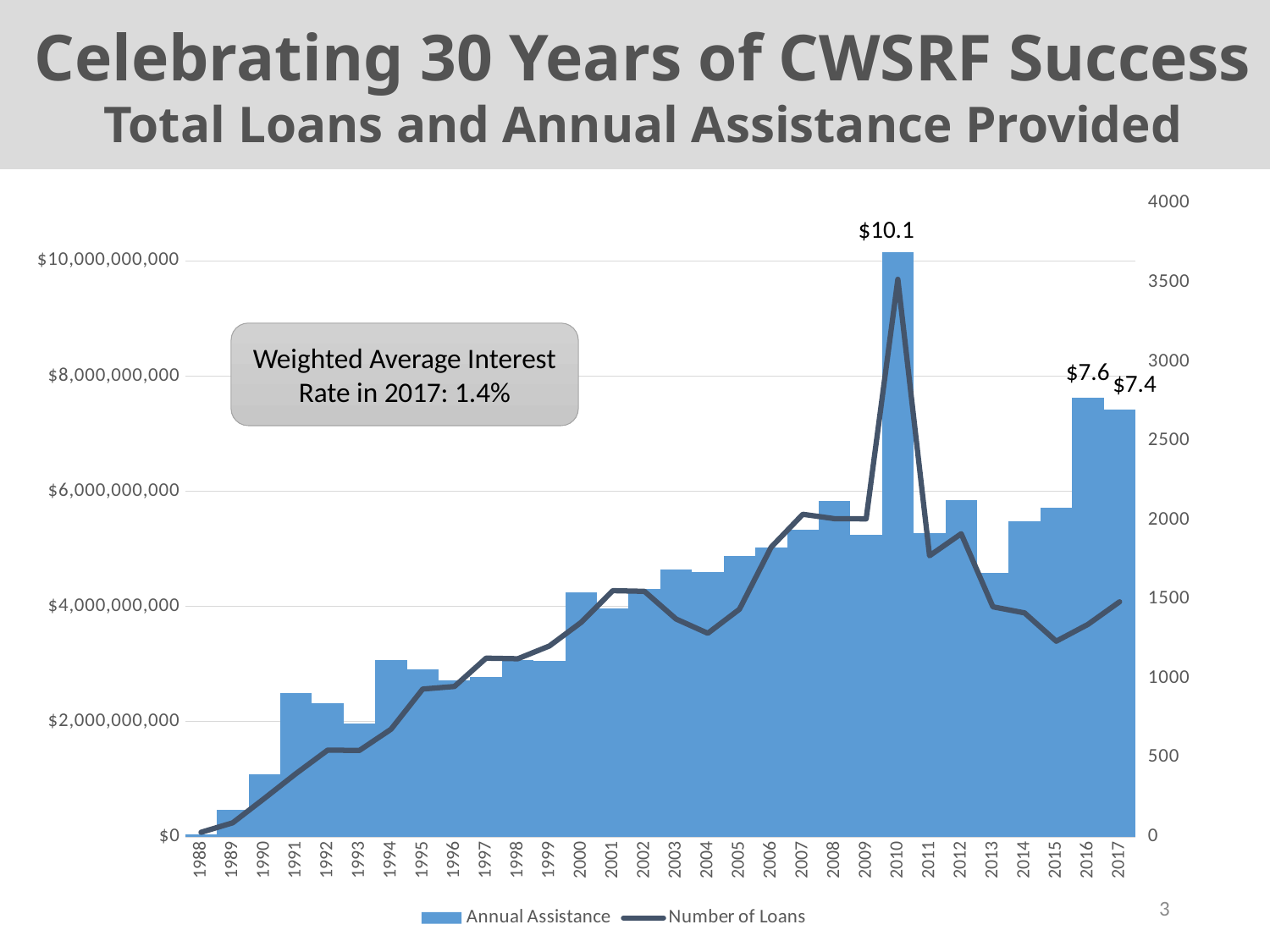
Which year has the lowest Annual Assistance bar? 1988 Which year has the larger Annual Assistance value, 2016 or 2017? 2016 Is the Number of Loans value for 2010 greater or less than 3000? greater What is the data label shown for Annual Assistance in 2016? $7.6 Which year has the highest Annual Assistance bar? 2010 What kind of chart is shown on the slide? A bar chart combined with a line chart What is the difference between the labelled Annual Assistance values for 2016 and 2017? $0.2 How many years are shown on the x axis of the chart? 30 What is the data label shown for Annual Assistance in 2010? $10.1 What is the data label shown for Annual Assistance in 2017? $7.4 Is the Annual Assistance value for 2003 greater or less than $4,000,000,000? greater How many series does the chart legend list? 2